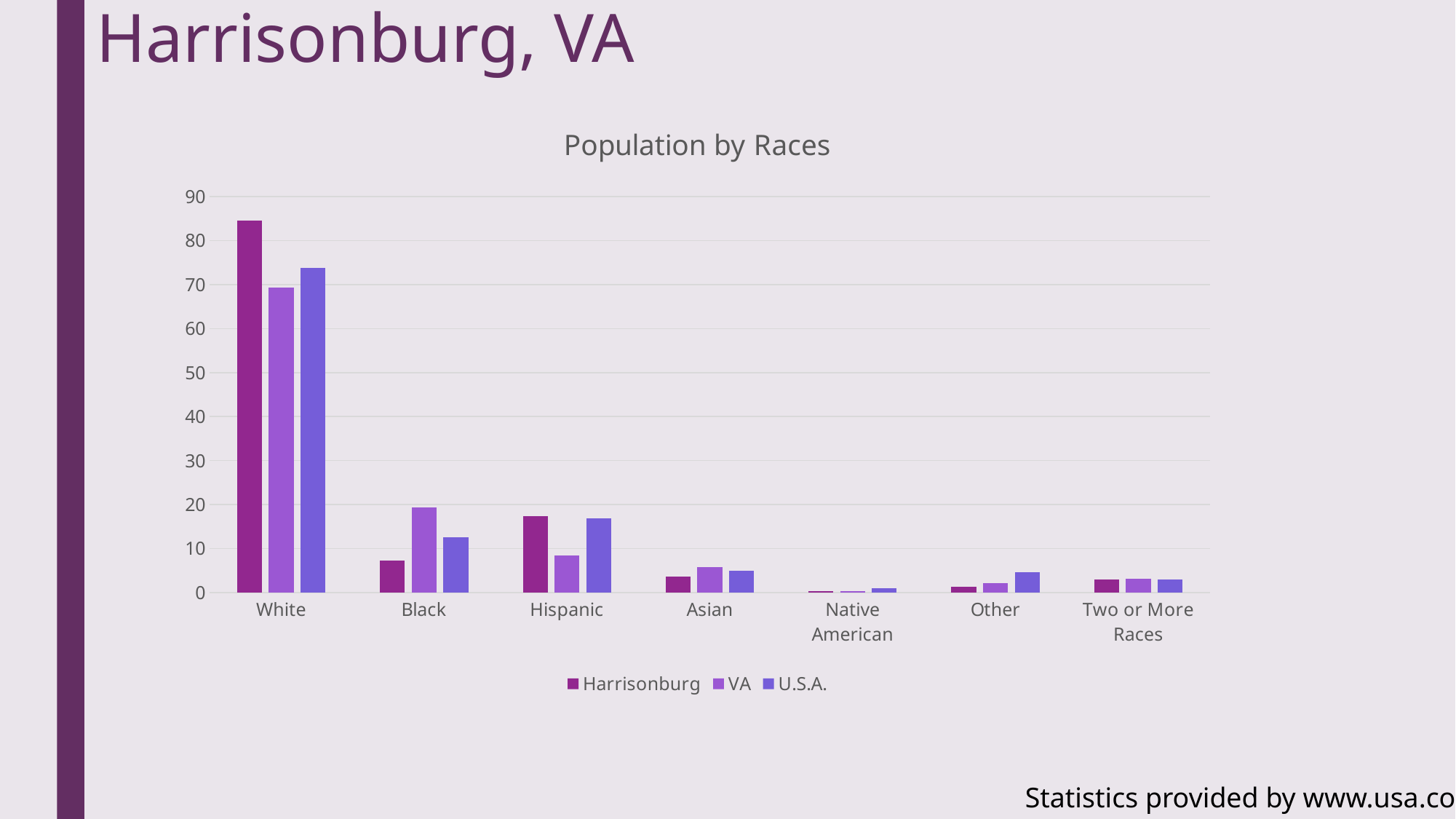
Which category has the highest value for the Harrisonburg series? White For the Black category, which series has the larger value: Harrisonburg or VA? VA How many series does the legend of the Population by Races chart list? 3 What is the title of the chart on the slide? Population by Races How many race categories are shown on the x axis of the chart? 7 For the Hispanic category, which series has the larger value: Harrisonburg or VA? Harrisonburg What are the three series listed in the chart's legend? Harrisonburg, VA, U.S.A. Is the U.S.A. value for White greater or less than 70? greater Which category has the lowest value for the Harrisonburg series? Native American Is the VA value for Black greater or less than 20? less What kind of chart is shown on the slide? bar chart Is the Harrisonburg value for White greater or less than 80? greater